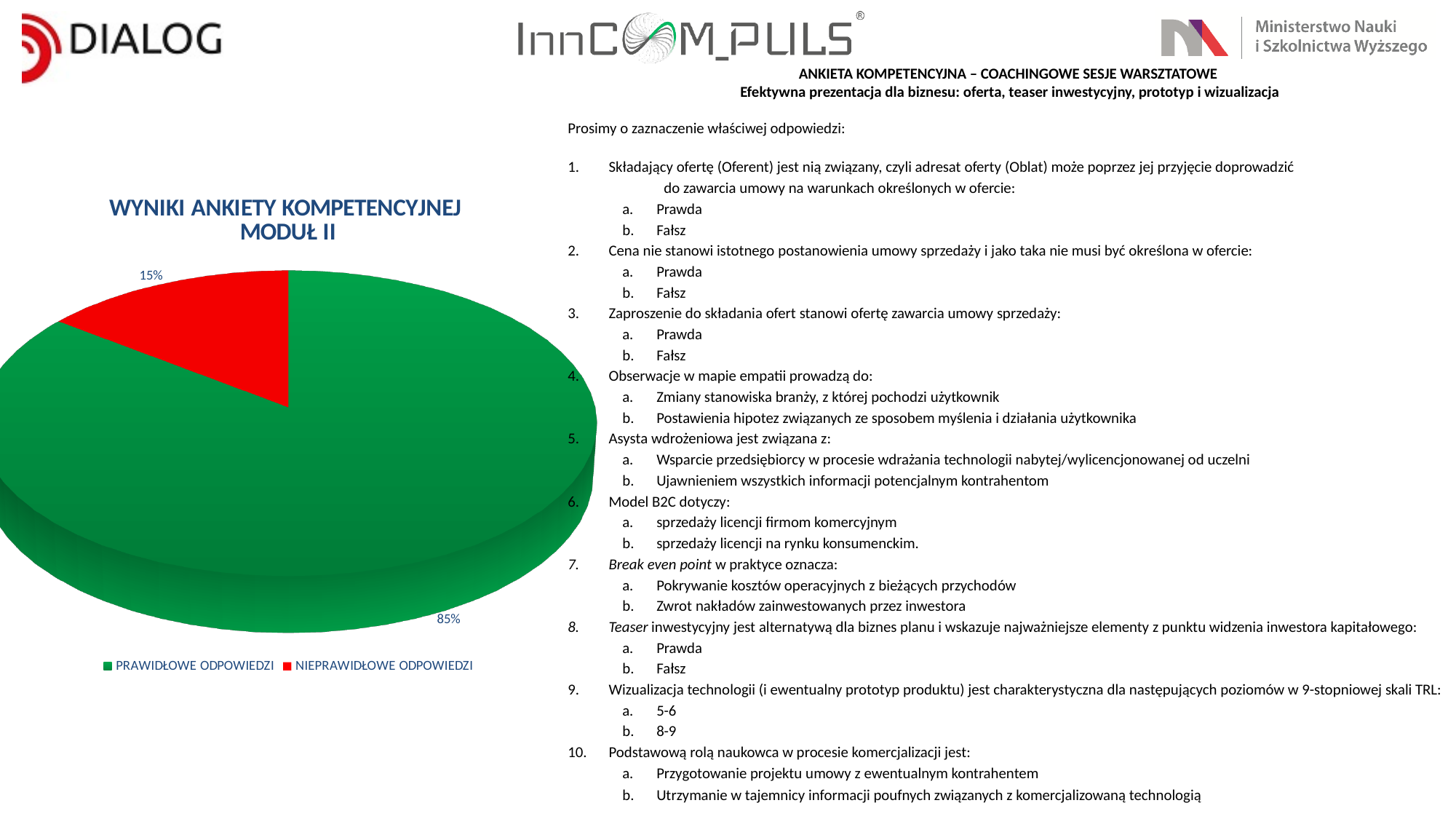
What is the title of the chart? WYNIKI ANKIETY KOMPETENCYJNEJ MODUŁ II What colour is the NIEPRAWIDŁOWE ODPOWIEDZI slice? Red What is the difference in percentage points between PRAWIDŁOWE ODPOWIEDZI and NIEPRAWIDŁOWE ODPOWIEDZI? 70 percentage points How many entries does the legend list? 2 Which slice of the pie is the largest? PRAWIDŁOWE ODPOWIEDZI What kind of chart is shown on the slide? Pie chart Which slice of the pie is the smallest? NIEPRAWIDŁOWE ODPOWIEDZI Which is larger, PRAWIDŁOWE ODPOWIEDZI or NIEPRAWIDŁOWE ODPOWIEDZI? PRAWIDŁOWE ODPOWIEDZI What share of the pie is PRAWIDŁOWE ODPOWIEDZI? 85% What share of the pie is NIEPRAWIDŁOWE ODPOWIEDZI? 15% How many slices does the pie chart have? 2